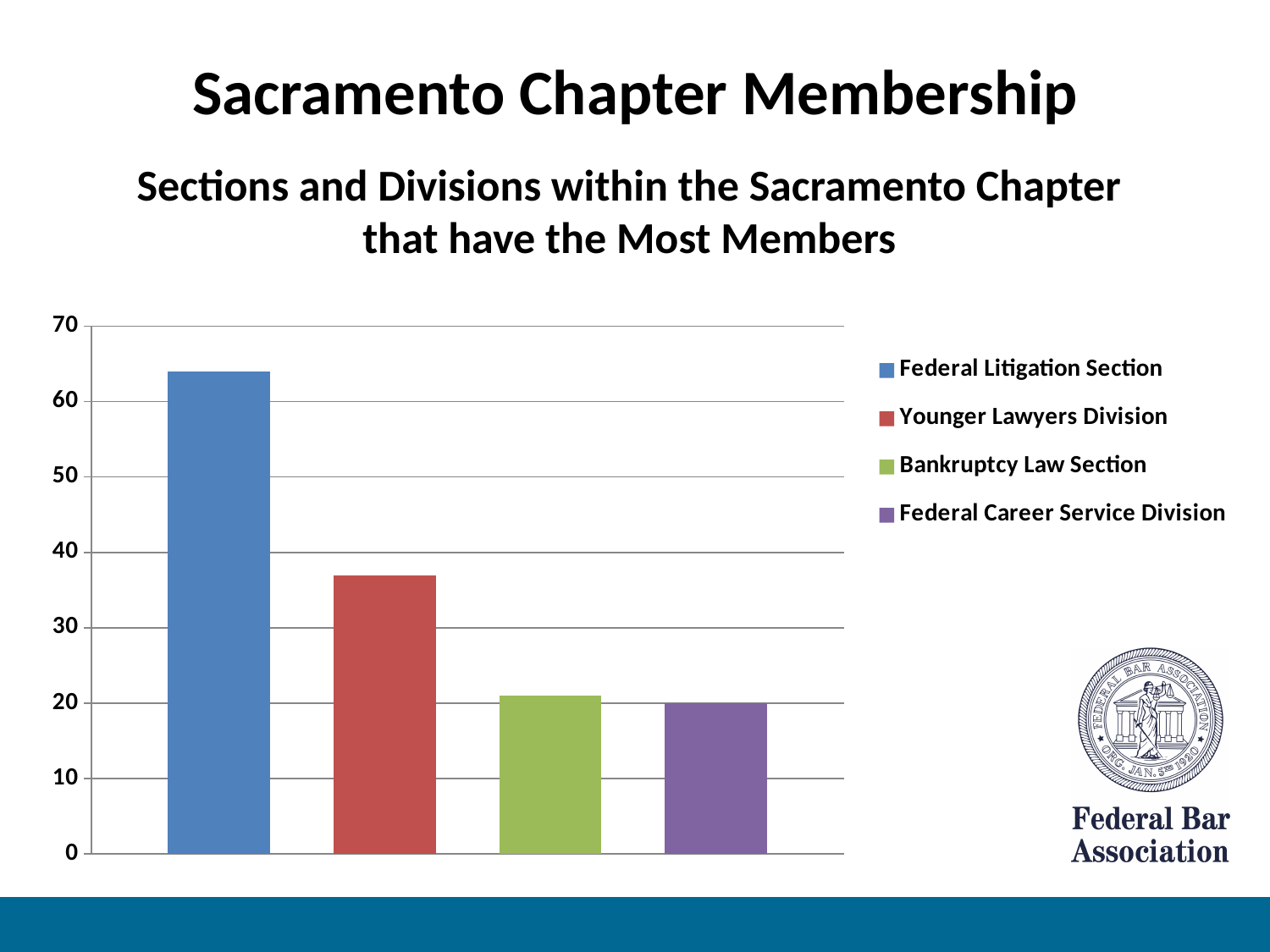
Is the value for Younger Lawyers Division greater or less than 40? less Which section or division has the highest number of members? Federal Litigation Section How many entries does the legend list? 4 Is the value for Younger Lawyers Division greater or less than 30? greater Is the value for Bankruptcy Law Section greater or less than 30? less What colour is the bar for Bankruptcy Law Section? green What type of chart is shown on the slide? bar chart Which is larger, the value for Federal Litigation Section or the value for Younger Lawyers Division? Federal Litigation Section Which is larger, the value for Younger Lawyers Division or the value for Bankruptcy Law Section? Younger Lawyers Division How many bars are plotted in the chart? 4